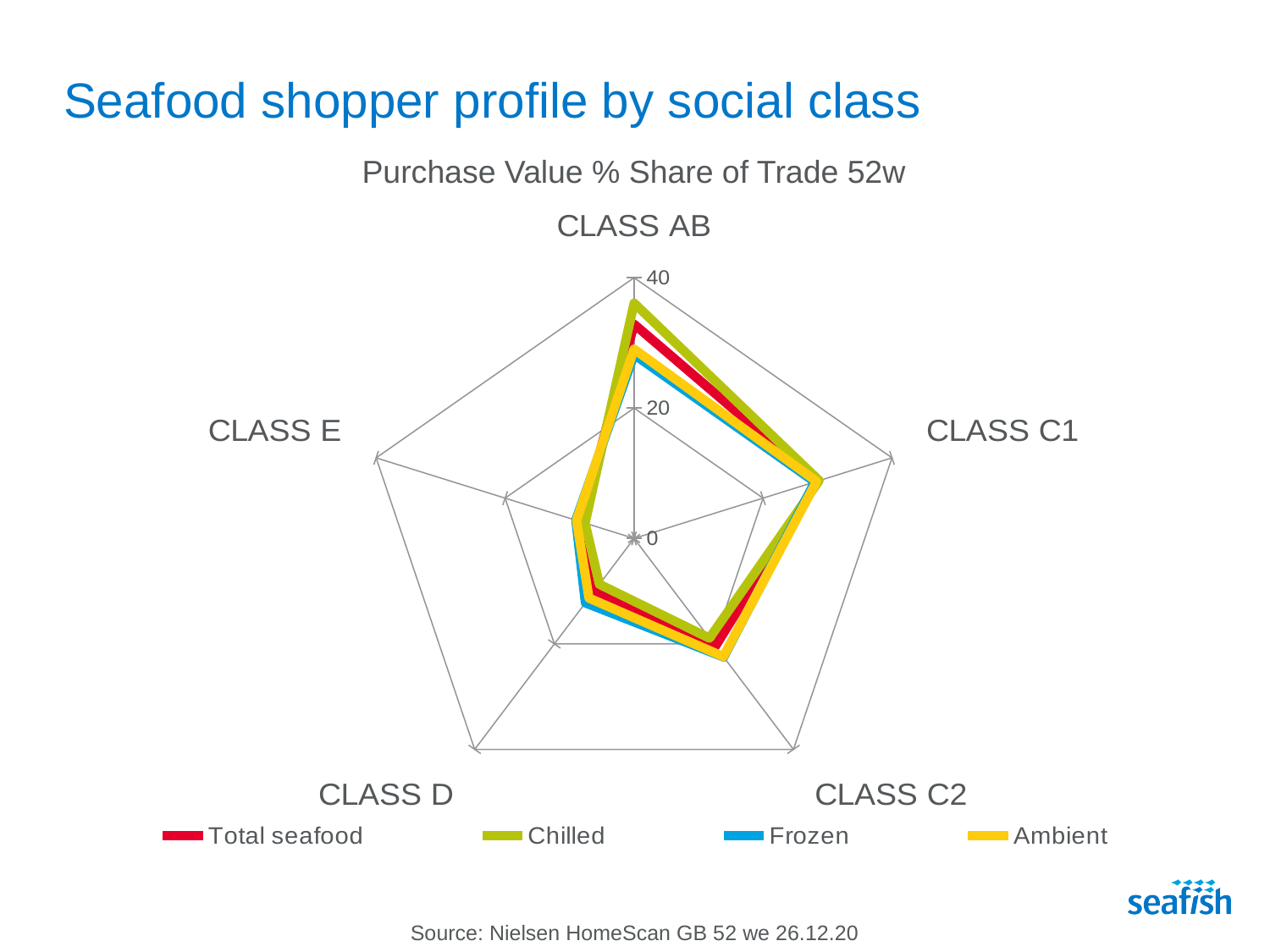
Is the Chilled value for CLASS AB greater or less than 20? greater Is the Total seafood value for CLASS D greater or less than 20? less Which series is drawn in blue? Frozen For CLASS AB, which is larger: the Chilled value or the Frozen value? Chilled Is the Frozen value for CLASS E greater or less than 20? less What is the title of the chart? Purchase Value % Share of Trade 52w How many series does the legend list? 4 How many social class categories does the chart plot? 5 What kind of chart is shown on the slide? Radar chart For CLASS D, which is larger: the Frozen value or the Chilled value? Frozen For the Chilled series, which social class has the highest value? CLASS AB